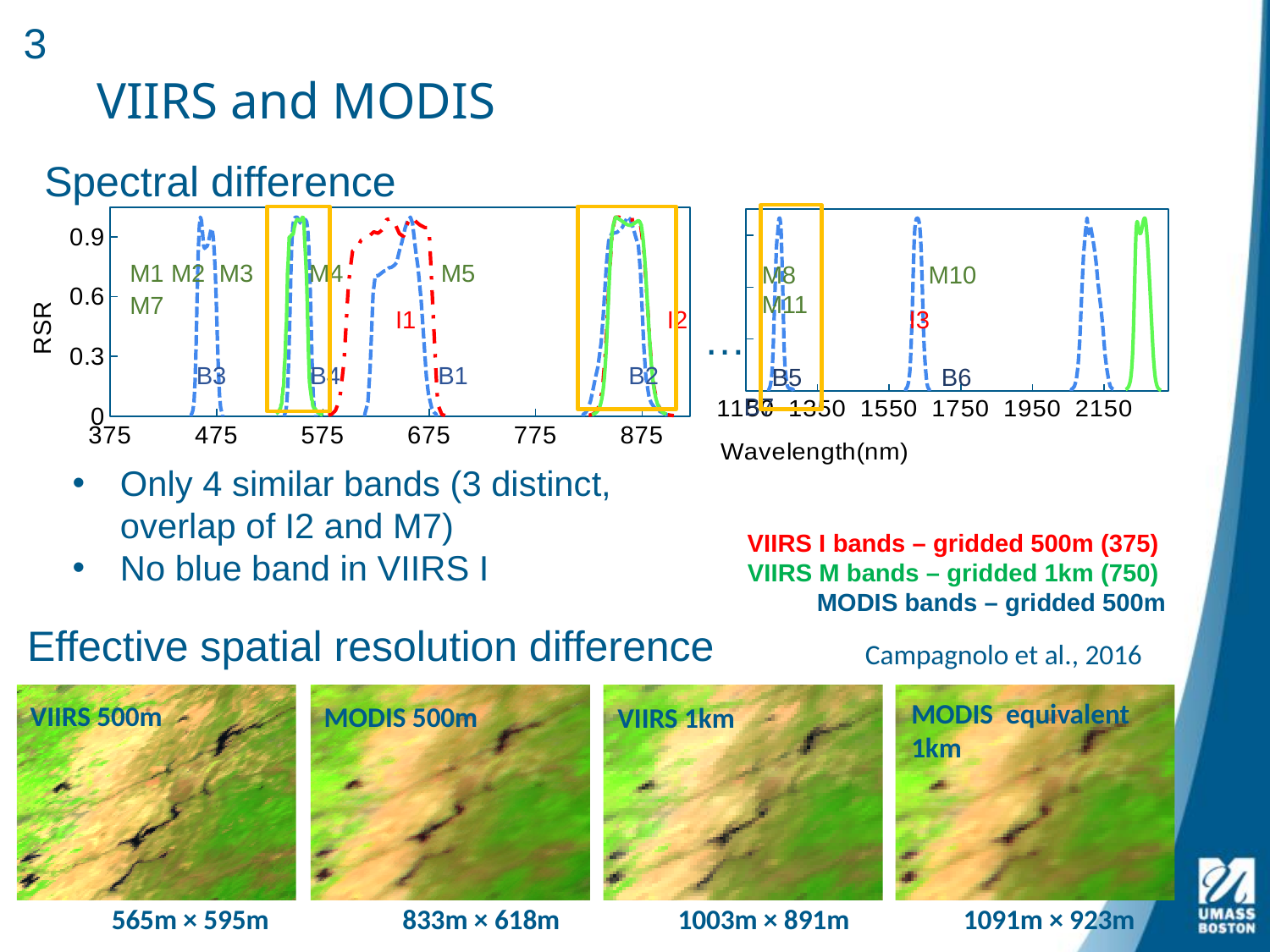
What is the highest wavelength tick label shown on the x axis of the right panel of the spectral difference chart? 2150 What kind of chart is used to show the spectral difference between VIIRS and MODIS? line chart What is the lowest wavelength tick label shown on the x axis of the left panel of the spectral difference chart? 375 In the spectral difference chart, is the peak value of the B3 band greater or less than 0.6? greater In the spectral difference chart, which colour is used for the MODIS bands? blue (dashed) How many orange highlight boxes are drawn on the spectral difference chart? 3 In the spectral difference chart, what is the label on the y axis? RSR In the spectral difference chart, is the peak value of the I1 band greater or less than 0.9? greater What is the highest tick value labelled on the y axis of the spectral difference chart? 0.9 In the spectral difference chart, is the RSR value of the M7 band at 775 nm greater or less than 0.3? less How many wavelength tick labels are shown on the x axis of the left panel of the spectral difference chart? 6